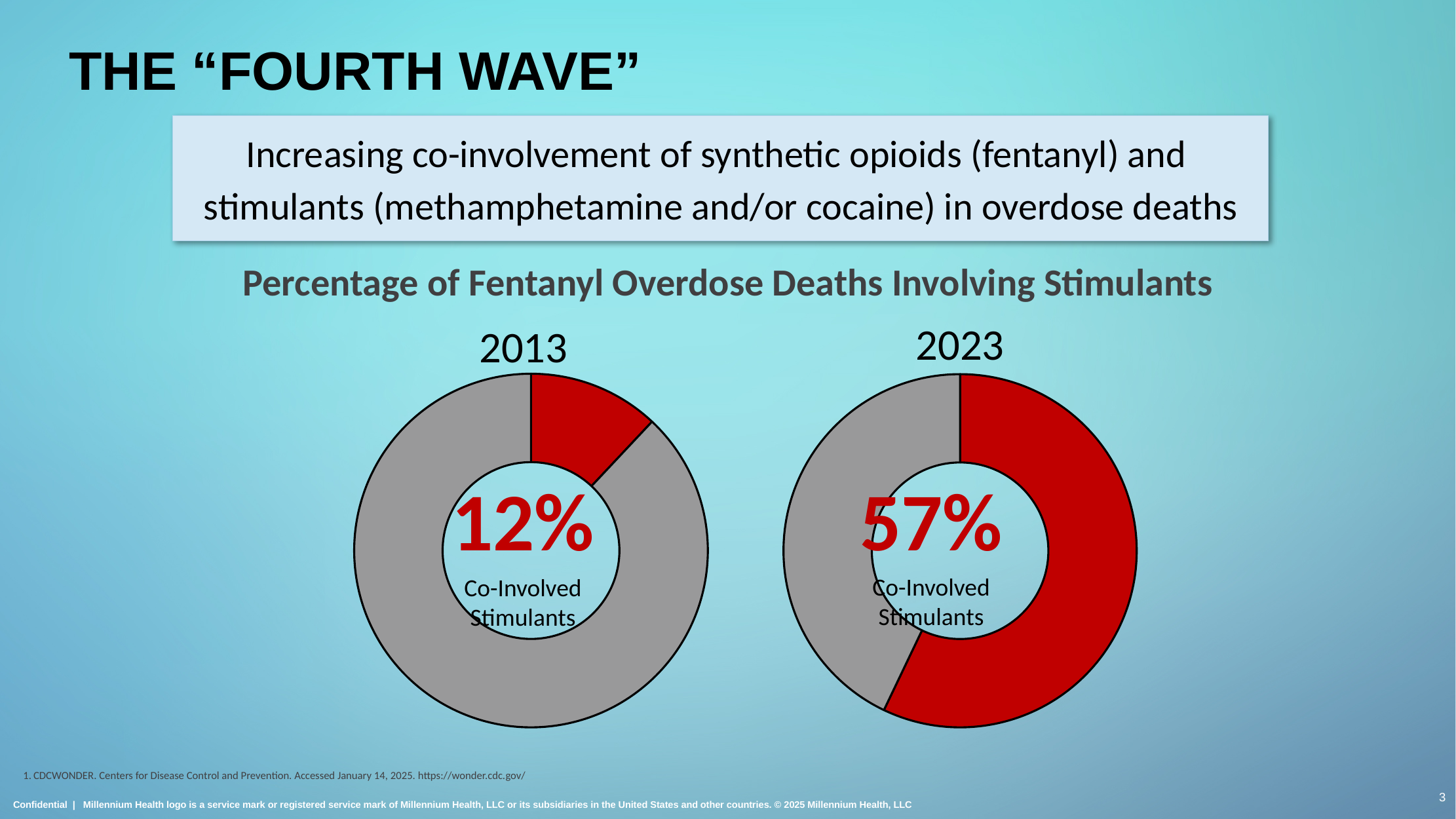
What kind of chart is used to show the 2013 and 2023 percentages? Donut (pie) chart What colour is used for the co-involved stimulants slice in both donut charts? Red Is the 2023 value for co-involved stimulants greater or less than 50%? greater In the 2023 donut chart, what percentage of fentanyl overdose deaths involved co-involved stimulants? 57% By how many percentage points did the share of fentanyl overdose deaths involving stimulants increase from the 2013 chart to the 2023 chart? 45 percentage points Which chart shows the larger share of fentanyl overdose deaths involving stimulants, 2013 or 2023? 2023 In the 2013 donut chart, what percentage of fentanyl overdose deaths involved co-involved stimulants? 12% What is the title shown above the two donut charts? Percentage of Fentanyl Overdose Deaths Involving Stimulants Does the percentage of fentanyl overdose deaths involving stimulants rise or fall from 2013 to 2023? Rise How many slices does the 2013 donut chart have? 2 In the 2013 donut chart, what share of the circle is not co-involved stimulants (the grey portion)? 88% In the 2023 donut chart, what share of the circle is the grey portion? 43%